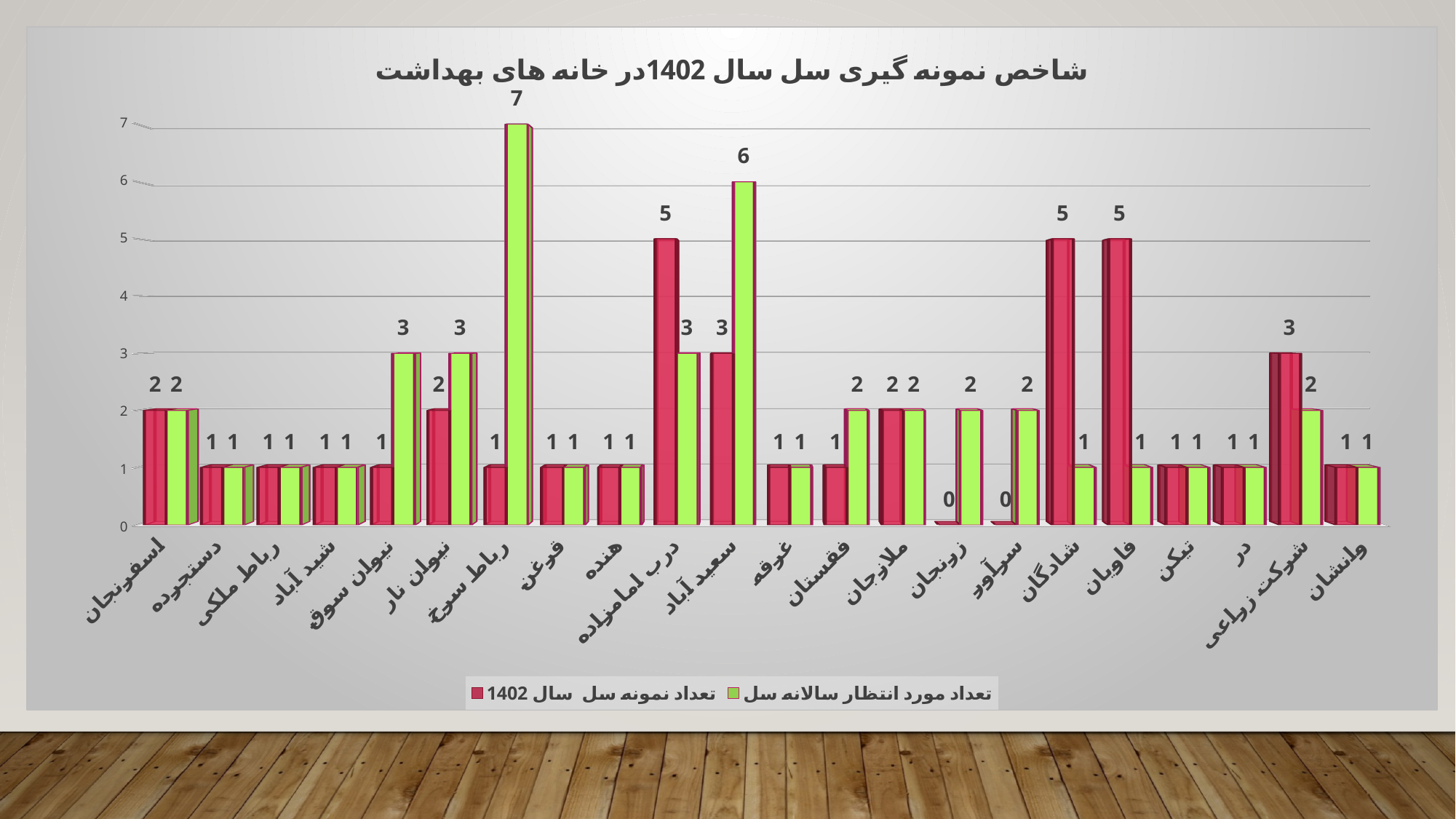
What type of chart is shown on the slide? bar chart Which category has the highest value in the green series (تعداد مورد انتظار سالانه سل)? رباط سرخ What is the value of the red series (تعداد نمونه سل سال 1402) for زرنجان? 0 What is the value of the red series (تعداد نمونه سل سال 1402) for درب امامزاده? 5 For شادگان, which series has the larger value, the red (تعداد نمونه سل سال 1402) or the green (تعداد مورد انتظار سالانه سل)? red (تعداد نمونه سل سال 1402) What is the value of the green series (تعداد مورد انتظار سالانه سل) for رباط سرخ? 7 What is the title of the chart? شاخص نمونه گیری سل سال 1402در خانه های بهداشت What is the difference between the green and red values for سعید آباد? 3 What is the difference between the green and red values for رباط سرخ? 6 How many categories are shown on the x axis? 22 What is the value of the green series (تعداد مورد انتظار سالانه سل) for سعید آباد? 6 How many series does the legend list? 2